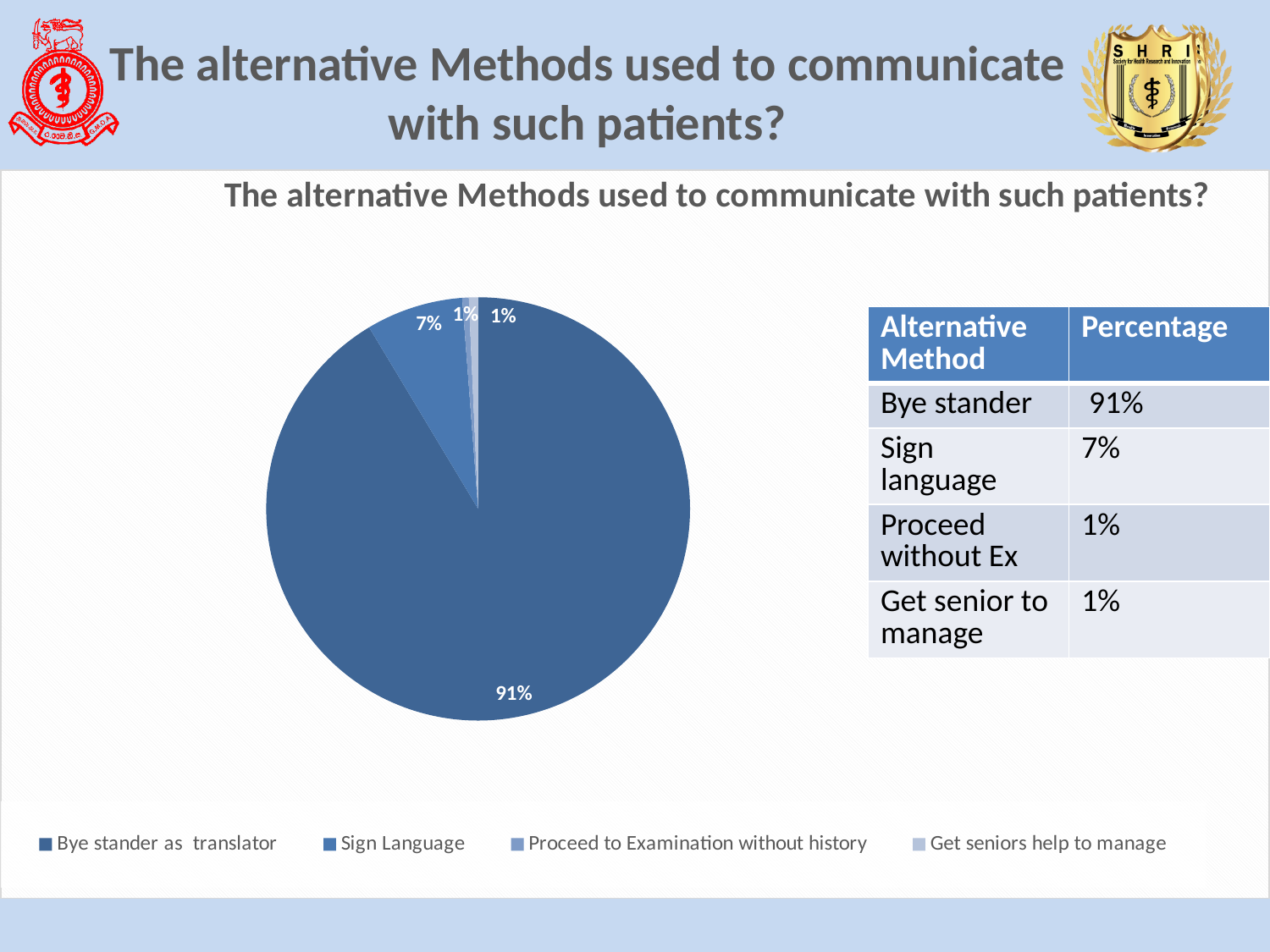
What percentage of the pie is labelled for 'Proceed to Examination without history'? 1% How many entries does the legend list? 4 What percentage of the pie is labelled for 'Bye stander as translator'? 91% What percentage of the pie is labelled for 'Get seniors help to manage'? 1% What type of chart is shown on the slide? Pie chart What percentage of the pie is labelled for 'Sign Language'? 7% How many slices does the pie chart have? 4 Which slice is larger: 'Sign Language' or 'Proceed to Examination without history'? Sign Language What is the difference in percentage points between the 'Bye stander as translator' slice and the 'Sign Language' slice? 84 What is the title of the chart? The alternative Methods used to communicate with such patients? What is the combined percentage of the 'Proceed to Examination without history' and 'Get seniors help to manage' slices? 2% Which category has the largest slice of the pie? Bye stander as translator